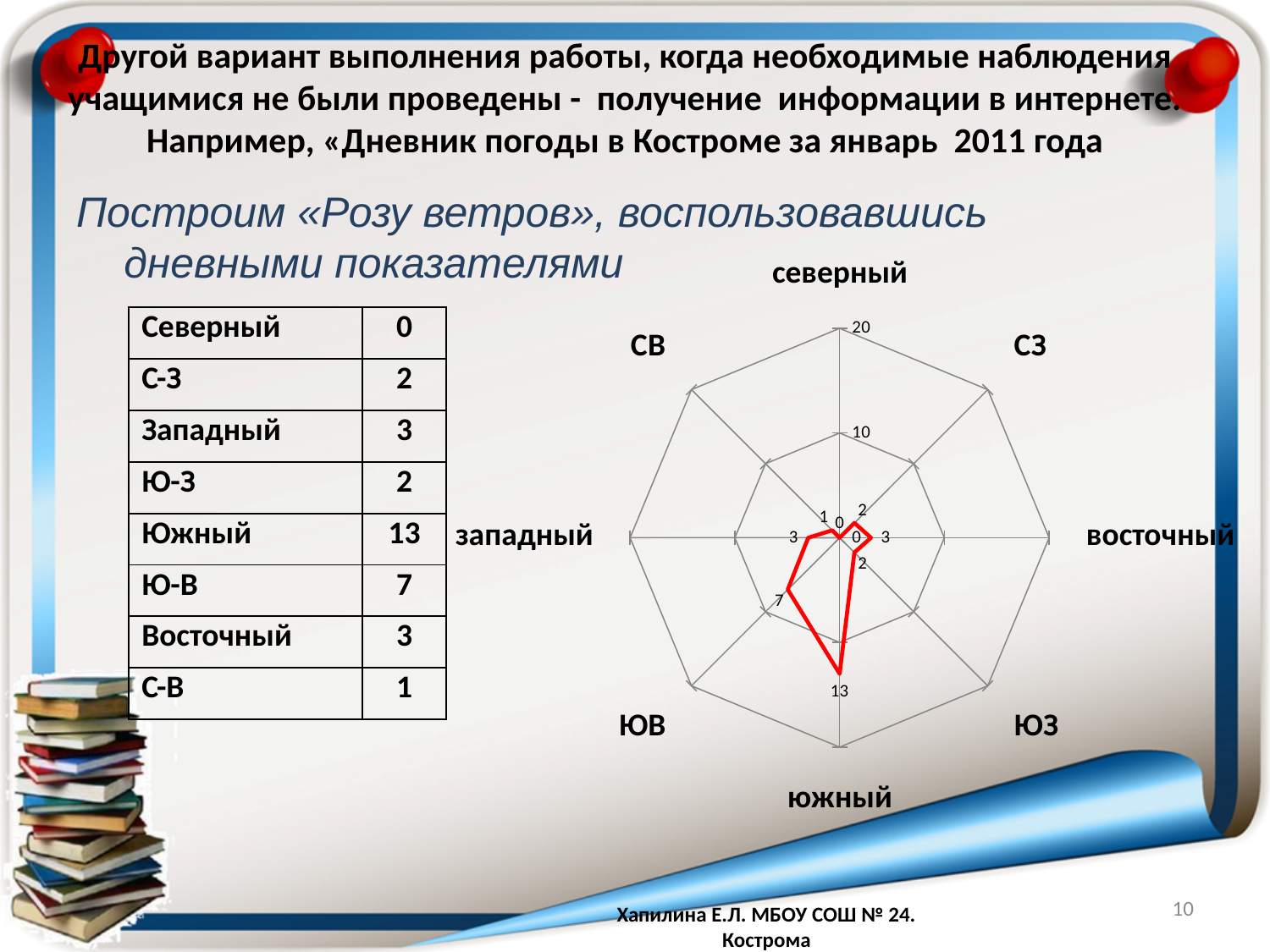
Which has the larger value on the radar chart, ЮВ or СЗ? ЮВ What is the difference between the values for южный and ЮВ on the radar chart? 6 What is the maximum value shown on the radial axis of the radar chart? 20 Which direction has the lowest value on the radar chart? северный What is the value plotted for западный on the radar chart? 3 What is the value plotted for ЮВ on the radar chart? 7 Is the value for южный on the radar chart greater or less than 10? greater Which direction has the highest value on the radar chart? южный How many wind directions (categories) are plotted on the radar chart? 8 What kind of chart is shown on the slide? radar chart What is the value plotted for северный on the radar chart? 0 What is the value plotted for южный on the radar chart? 13